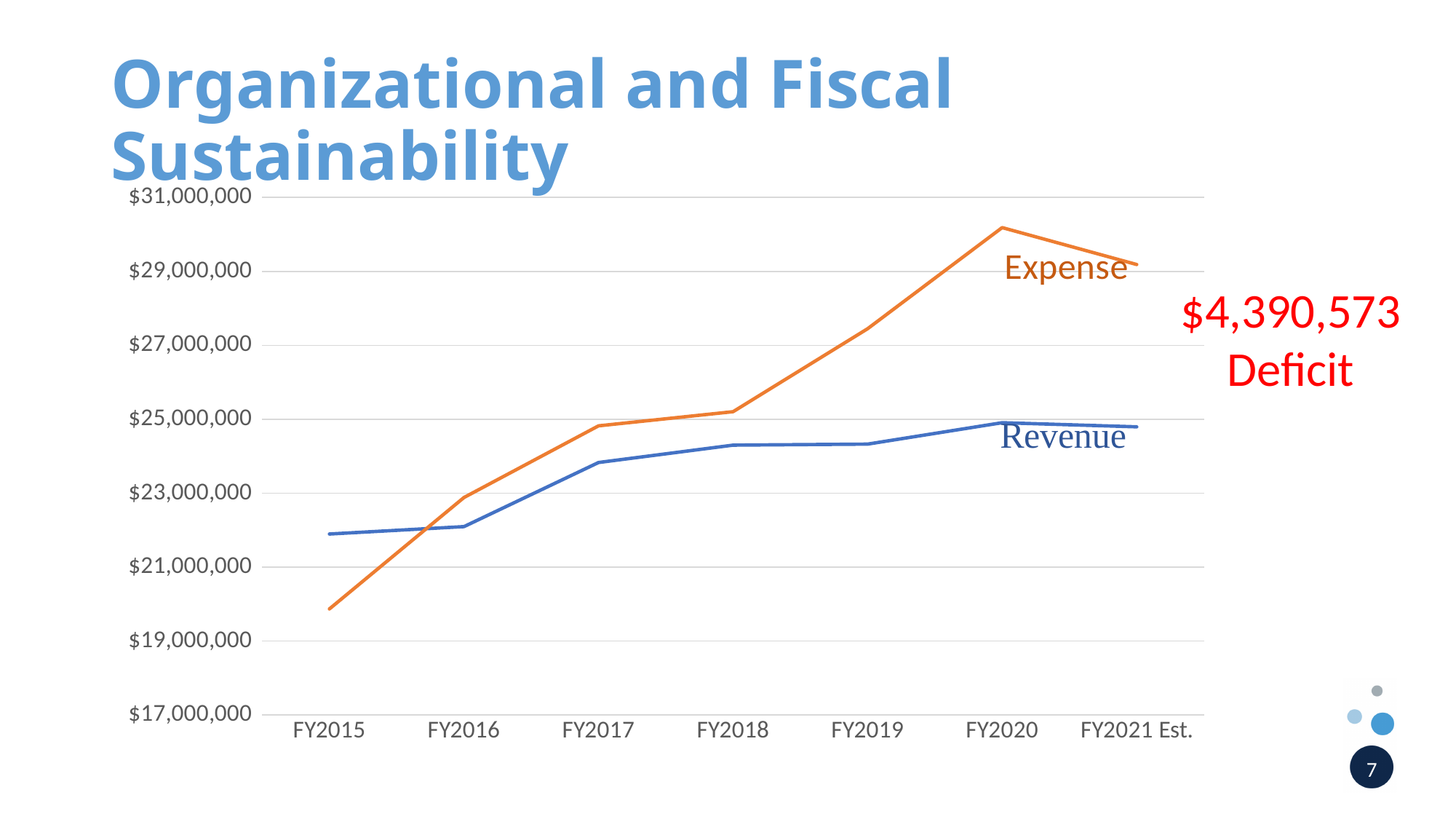
In which fiscal year is Revenue lowest? FY2015 In which fiscal year is Expense lowest? FY2015 In FY2015, which is larger, Revenue or Expense? Revenue Is the Expense value for FY2020 greater or less than $29,000,000? greater How many series are plotted on the chart? 2 In which fiscal year is Expense highest? FY2020 What kind of chart is shown on the slide? line chart Does Revenue rise or fall from FY2015 to FY2020? rise Is the Expense value for FY2015 greater or less than $21,000,000? less What deficit amount is annotated in red on the slide? $4,390,573 In FY2020, which is larger, Expense or Revenue? Expense How many fiscal years are plotted along the x axis? 7